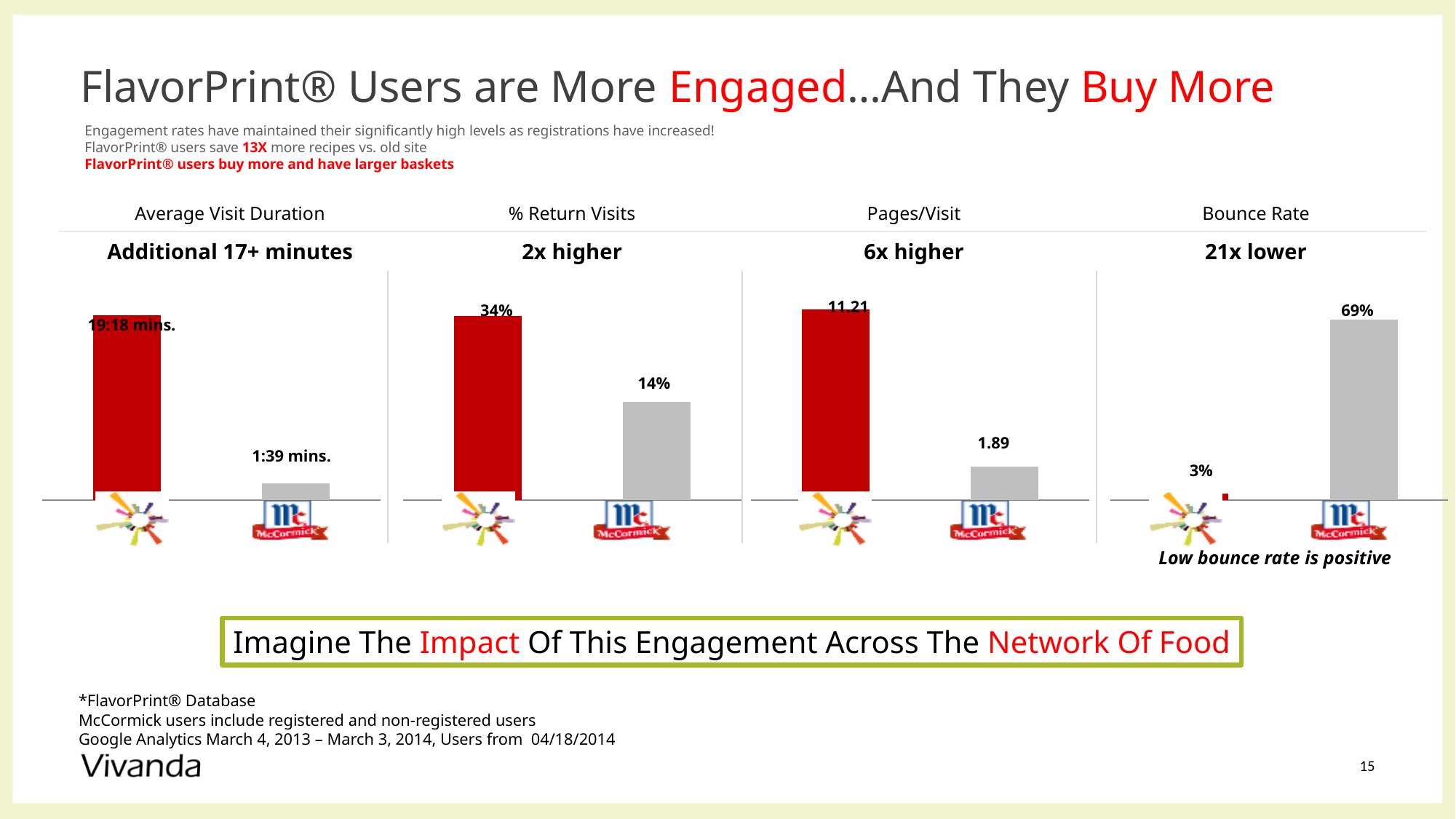
In the Pages/Visit chart, what is the value for McCormick? 1.89 In the Bounce Rate chart, what is the value for McCormick? 69% In the % Return Visits chart, what is the difference between the FlavorPrint and McCormick values? 20 percentage points In the % Return Visits chart, what is the value for McCormick? 14% What kind of chart is used for the Pages/Visit comparison? Bar chart In the % Return Visits chart, what is the value for FlavorPrint (the red bar)? 34% In the Average Visit Duration chart, what is the value for FlavorPrint (the red bar)? 19:18 mins. In the Bounce Rate chart, which is larger, the FlavorPrint value or the McCormick value? McCormick In the Average Visit Duration chart, what is the value for McCormick? 1:39 mins. In the Bounce Rate chart, what is the value for FlavorPrint (the red bar)? 3% In the Pages/Visit chart, what is the difference between the FlavorPrint and McCormick values? 9.32 In the Pages/Visit chart, what is the value for FlavorPrint (the red bar)? 11.21